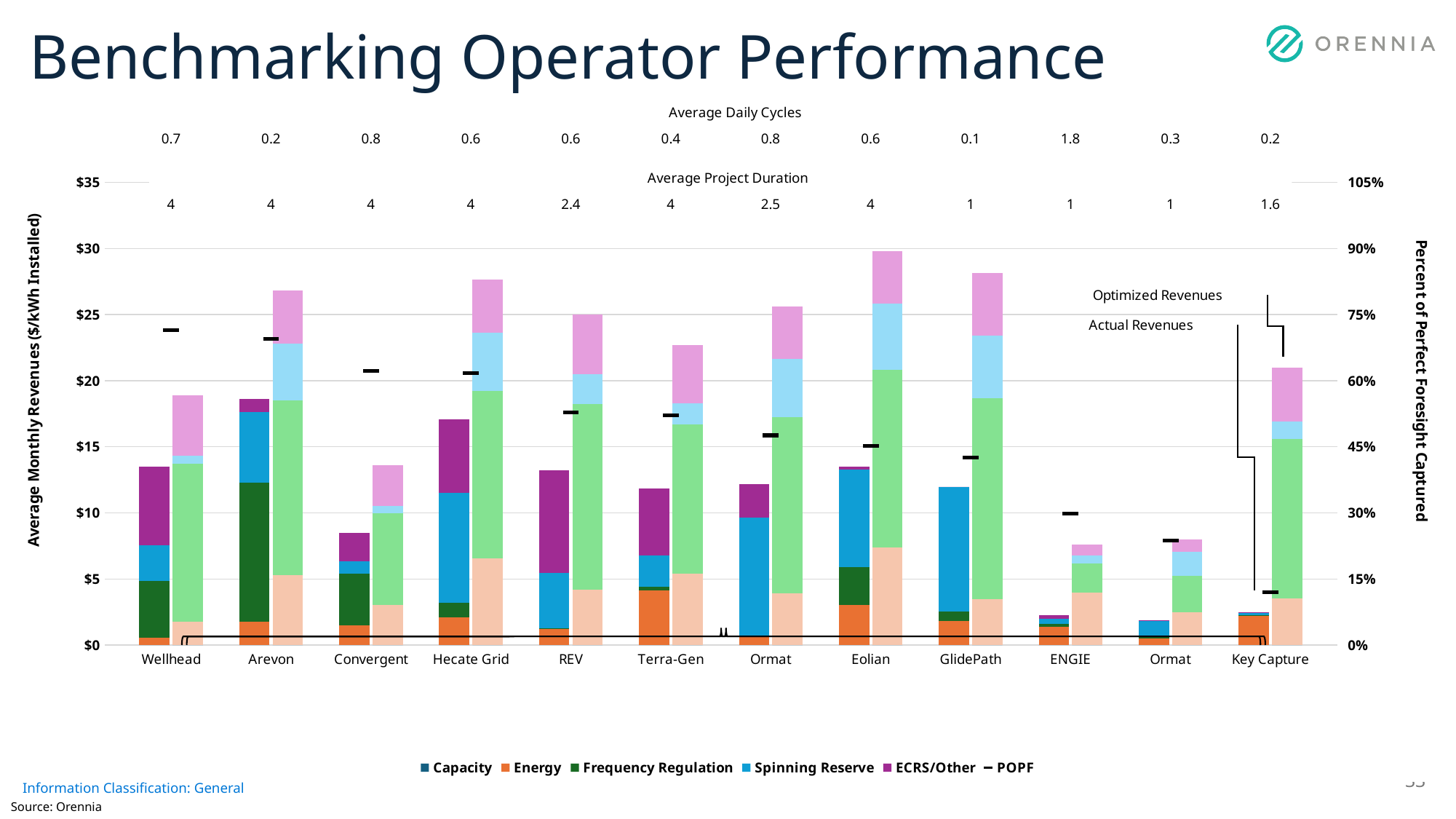
Is the optimized revenues bar for Eolian greater or less than $25? greater Is the actual revenues bar for ENGIE greater or less than $5? less Which has a higher Average Daily Cycles value, Convergent or Arevon? Convergent What is the Average Daily Cycles value shown for Wellhead? 0.7 What kind of chart is shown on the slide? Stacked bar chart How many entries does the legend list? 6 How many operators are shown along the x axis? 12 Which operator has the lowest Average Daily Cycles value? GlidePath What is the Average Daily Cycles value shown for ENGIE? 1.8 What is the difference between the Average Daily Cycles values for Wellhead and Arevon? 0.5 What is the Average Project Duration shown for REV? 2.4 Which operator has the highest Average Daily Cycles value? ENGIE